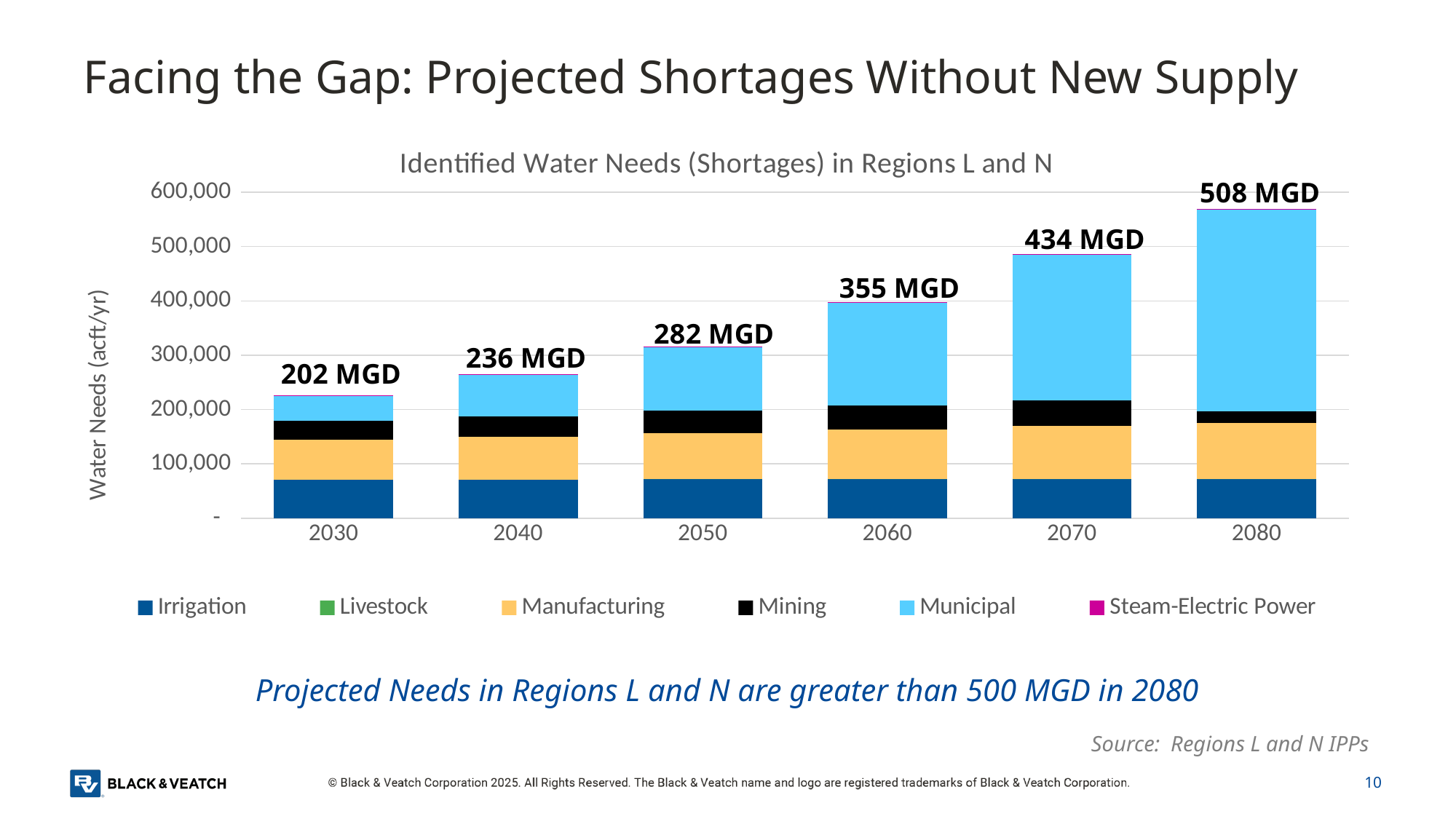
What is the labelled value for 2030? 202 MGD Is the total height of the 2080 bar greater or less than 500,000 acft/yr? greater Which is larger, the labelled value for 2050 or for 2060? 2060 How many series does the legend list? 6 Do the water needs rise or fall from 2030 to 2080? rise Which year has the lowest labelled water need? 2030 What is the labelled value for 2080? 508 MGD What is the difference in MGD between the 2080 and 2030 labels? 306 MGD Which year has the highest labelled water need? 2080 Is the total height of the 2030 bar greater or less than 300,000 acft/yr? less What is the labelled value for 2060? 355 MGD How many years are shown on the x axis? 6